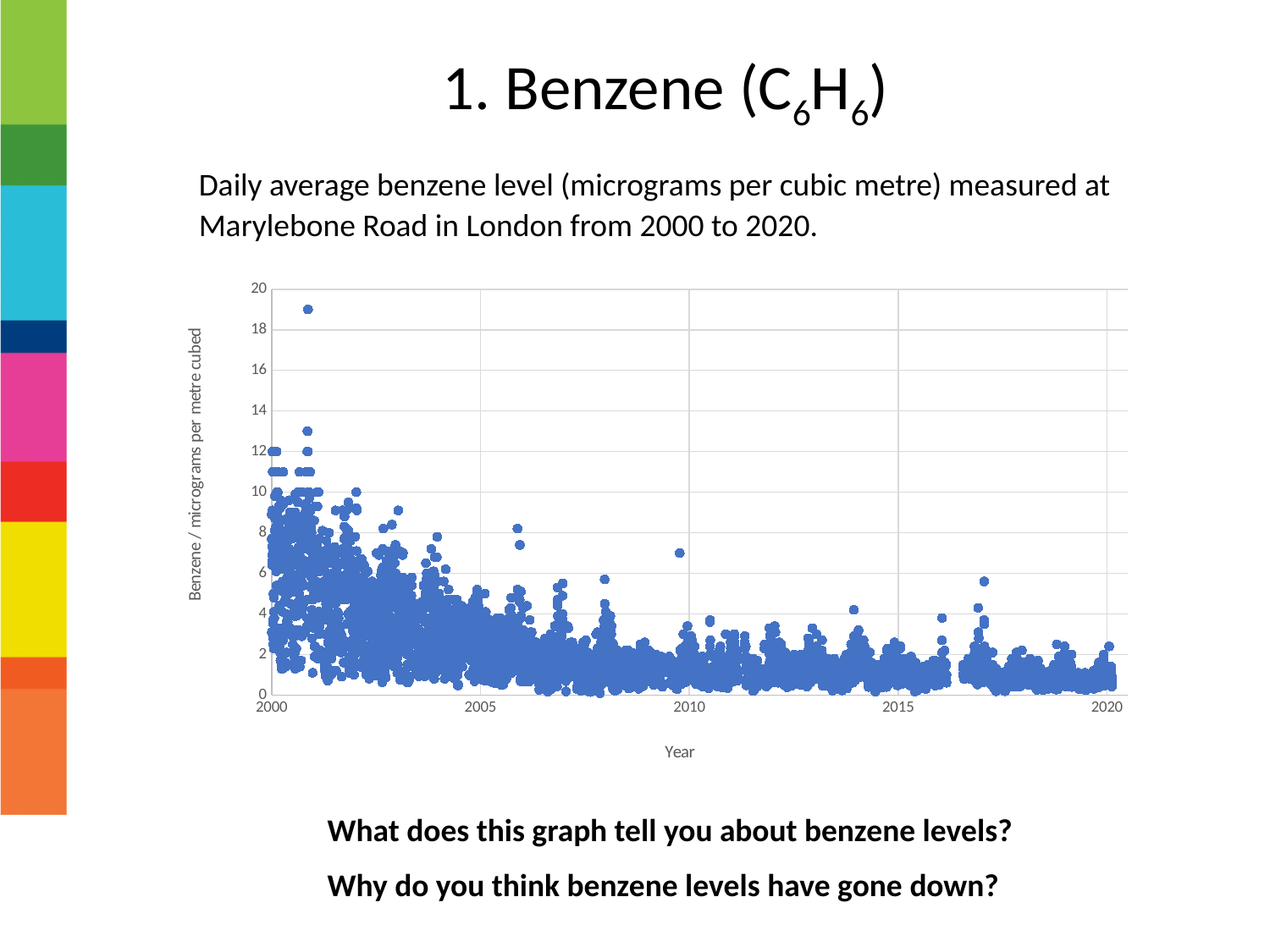
Are the benzene values plotted around 2018 greater or less than 6? less Is the highest plotted benzene value (around 2001) greater or less than 18? greater Are the highest benzene values plotted in 2000 larger or smaller than those plotted in 2020? larger Are the benzene values plotted for 2020 greater or less than 4? less What is the label of the x axis? Year What kind of chart is shown on the slide? scatter chart Do benzene levels generally rise or fall from 2000 to 2020 along the x axis? fall What is the label of the y axis? Benzene / micrograms per metre cubed